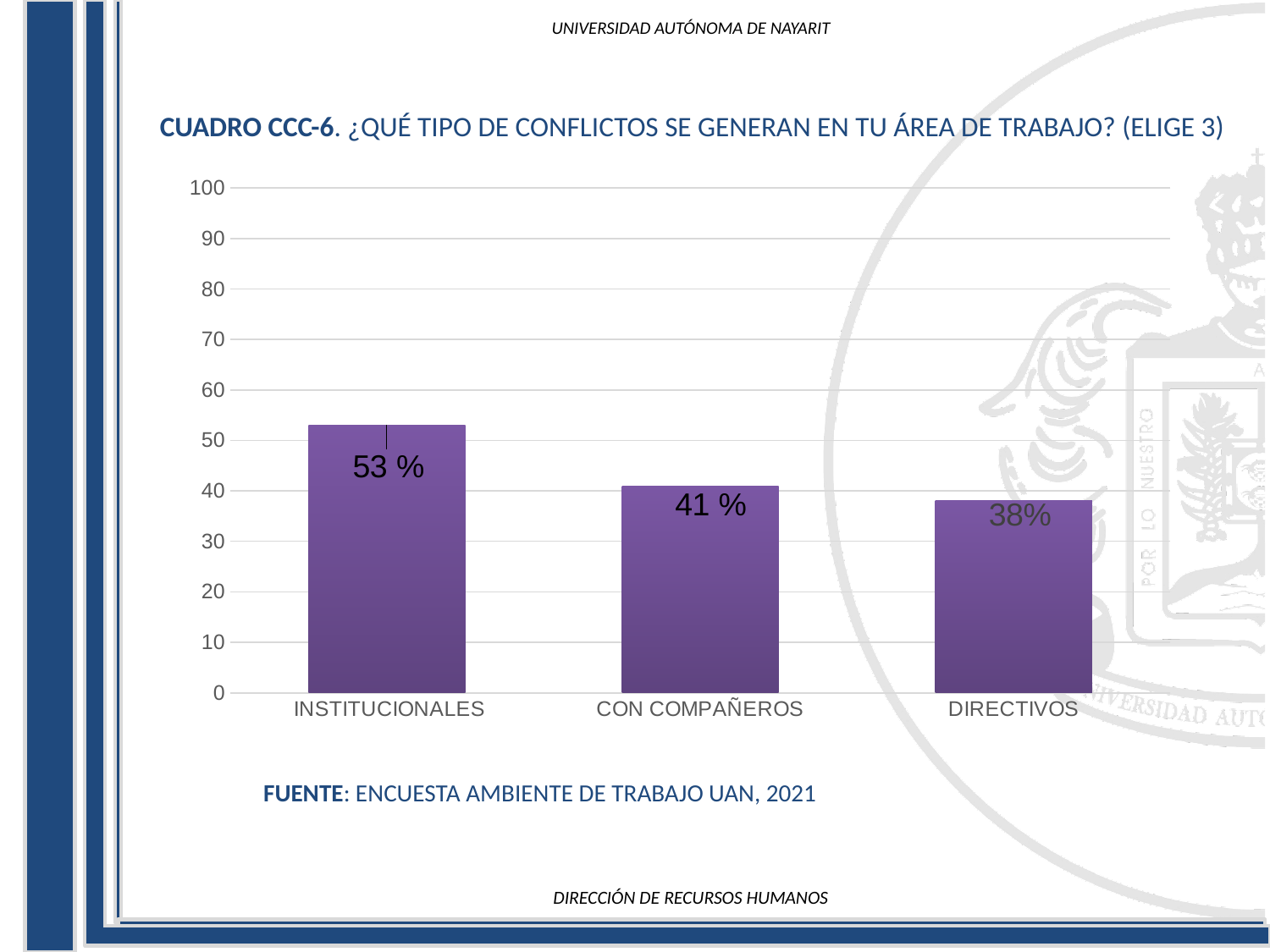
How many categories are shown on the x axis? 3 Which category has the lowest value? DIRECTIVOS Do the values rise or fall from left to right along the x axis? fall Which category has the highest value? INSTITUCIONALES What is the value for DIRECTIVOS? 38% Is the value for INSTITUCIONALES greater or less than 50? greater Which is larger, the value for CON COMPAÑEROS or the value for DIRECTIVOS? CON COMPAÑEROS What is the value for CON COMPAÑEROS? 41 % What is the difference between the values for INSTITUCIONALES and CON COMPAÑEROS? 12 What is the value for INSTITUCIONALES? 53 % What kind of chart is shown on the slide? bar chart What is the difference between the values for INSTITUCIONALES and DIRECTIVOS? 15